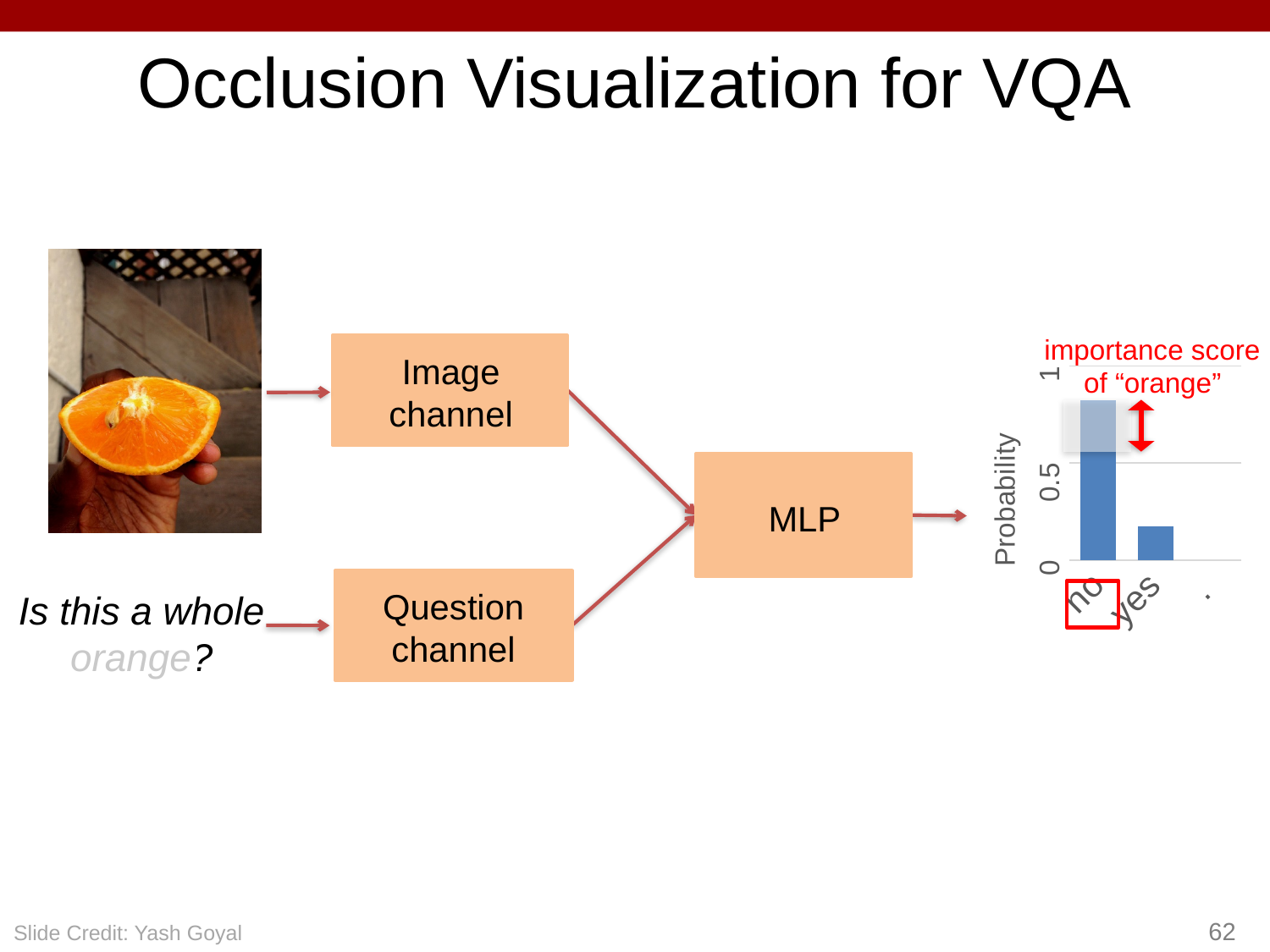
What kind of chart is shown on the right of the slide? bar chart Is the probability for "yes" in the bar chart greater or less than 0.5? less What is the highest tick value shown on the y axis of the bar chart? 1 In the bar chart, is the probability for "no" larger or smaller than the probability for "yes"? larger Which category has the lowest probability in the bar chart? yes What is the label of the y axis of the bar chart? Probability Which category has the highest probability in the bar chart? no Is the probability for "no" in the bar chart greater or less than 0.5? greater